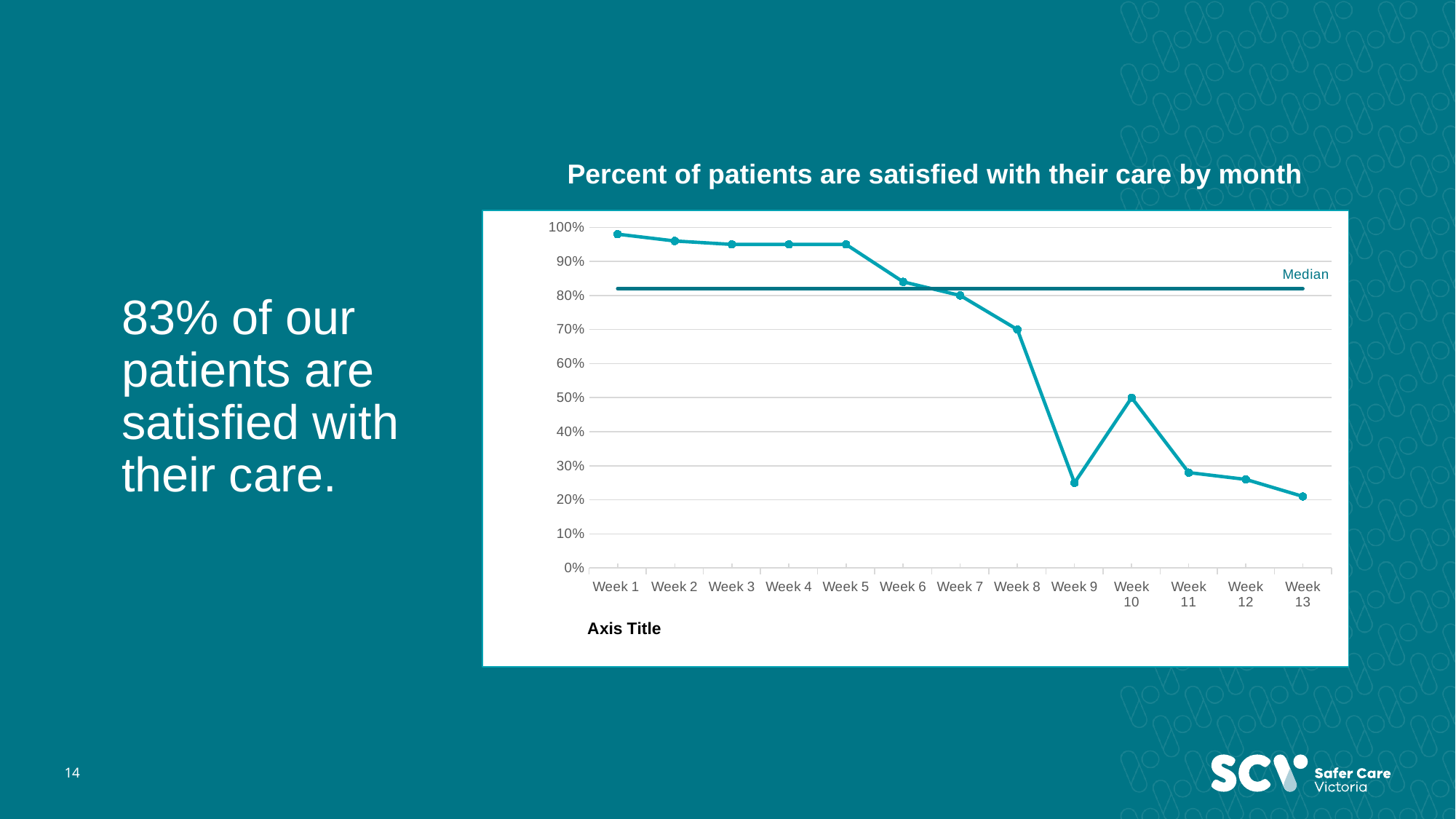
Is the value for Week 9 greater or less than 30%? less Which week has the lowest percentage of satisfied patients? Week 13 What is the title of the chart? Percent of patients are satisfied with their care by month What is the value for Week 8? 70% What is the value for Week 10? 50% Is the value for Week 1 greater or less than 90%? greater Is the value for Week 13 greater or less than 30%? less What type of chart is shown on the slide? line chart Overall, do the values rise or fall from Week 1 to Week 13? fall Which week has the highest percentage of satisfied patients? Week 1 How many weeks are plotted along the x axis of the chart? 13 Which is larger, the value for Week 9 or the value for Week 10? Week 10